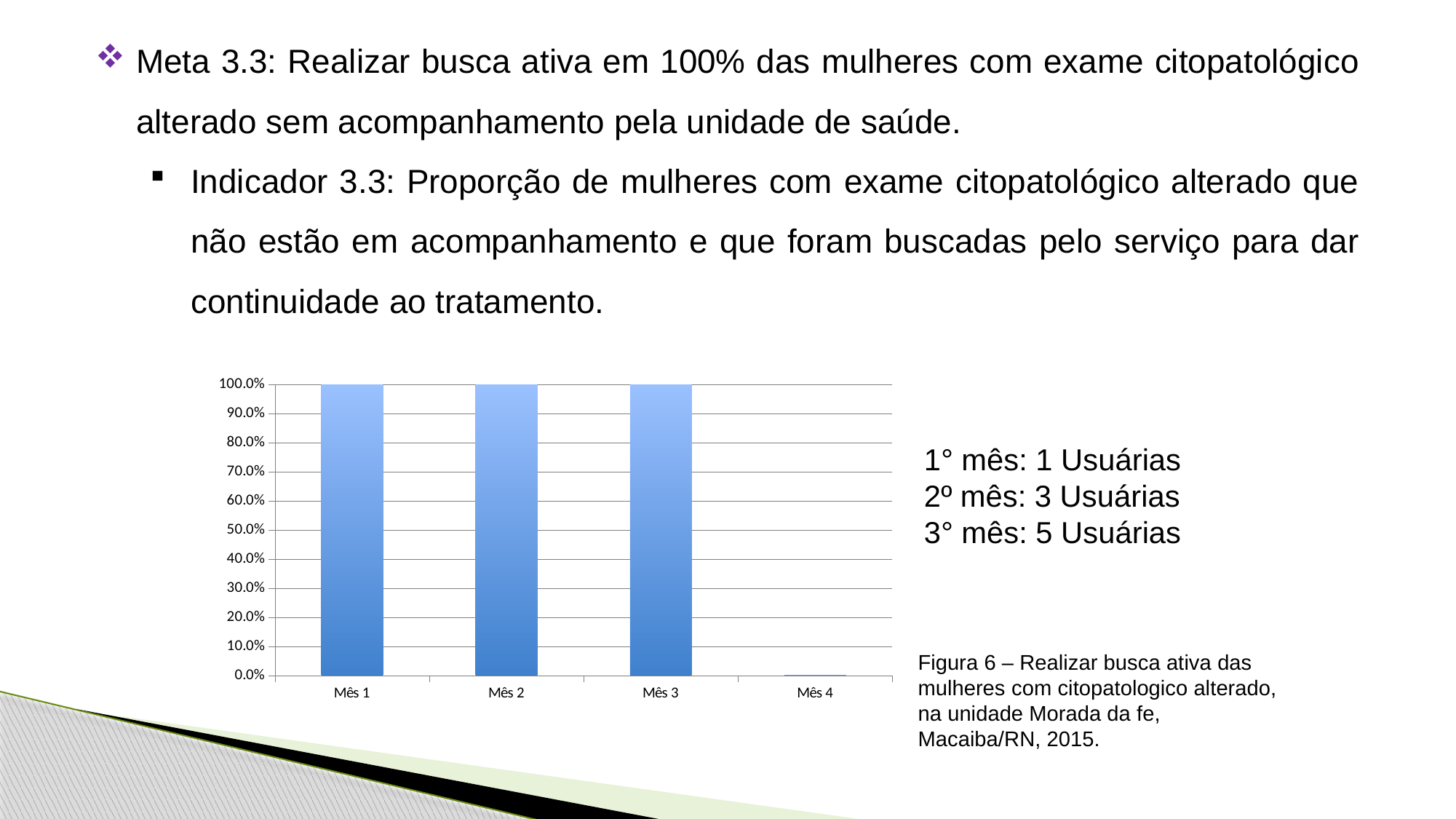
What figure number is given in the caption next to the chart? Figura 6 What is the highest tick label on the y axis of the chart? 100.0% Which is larger, the value for Mês 1 or the value for Mês 4? Mês 1 Which month has the lowest value in the chart? Mês 4 What is the value for Mês 3 in the chart? 100.0% What is the value for Mês 1 in the chart? 100.0% What is the value for Mês 2 in the chart? 100.0% Is the value for Mês 4 greater or less than 10.0%? less Does the value rise or fall from Mês 3 to Mês 4? fall How many months (categories) are shown on the x axis of the chart? 4 What kind of chart is shown on the slide? bar chart